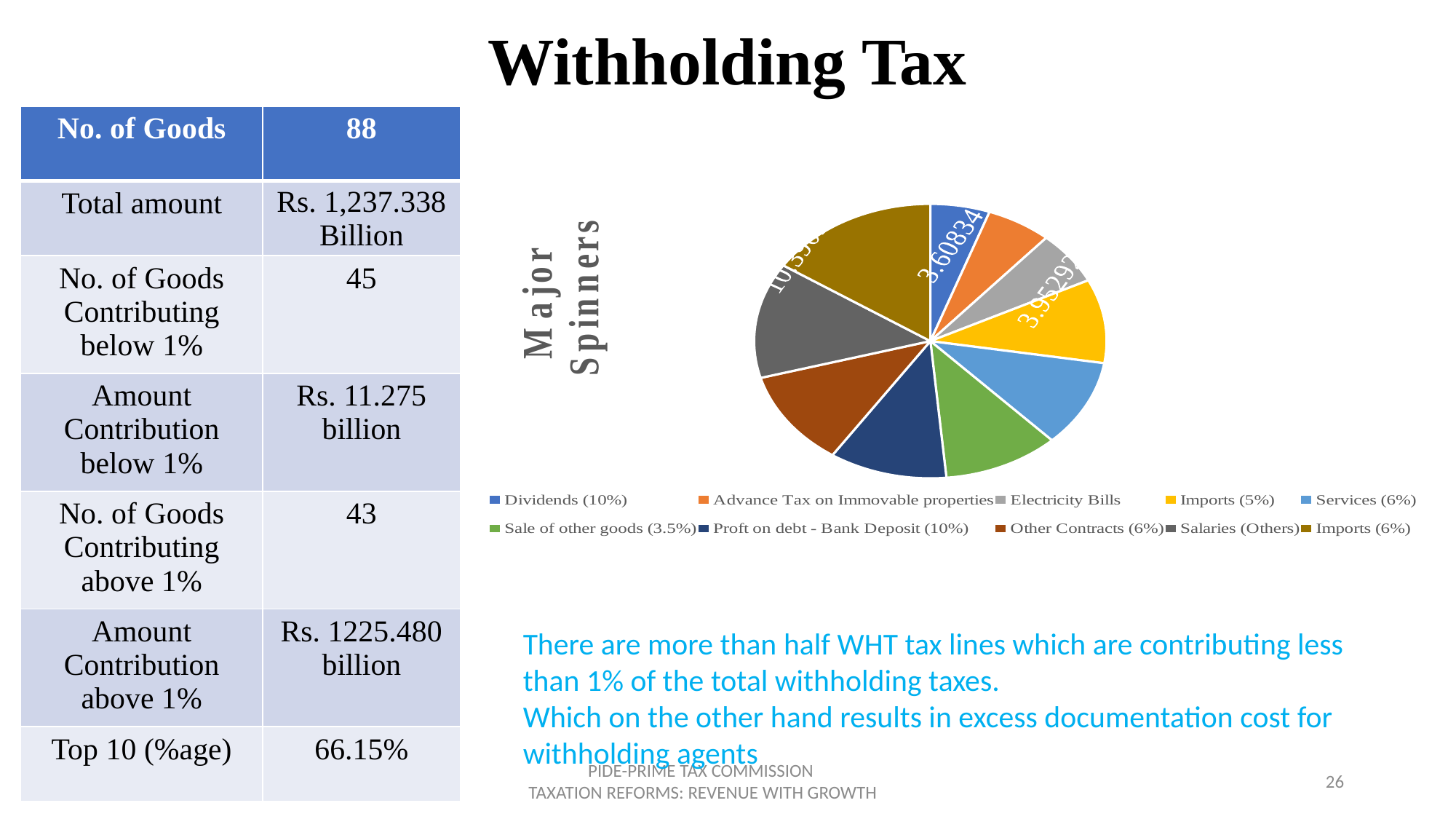
What value is printed on the Dividends (10%) slice of the pie chart? 3.60834 What kind of chart is shown on the slide? pie chart What colour is the Imports (5%) slice in the pie chart? yellow In the pie chart, which slice is larger: Salaries (Others) or Electricity Bills? Salaries (Others) How many categories does the pie chart's legend list? 10 In the pie chart, which slice is larger: Other Contracts (6%) or Electricity Bills? Other Contracts (6%) What is the title of the pie chart? Major Spinners In the pie chart, which slice is larger: Proft on debt - Bank Deposit (10%) or Advance Tax on Immovable properties? Proft on debt - Bank Deposit (10%)